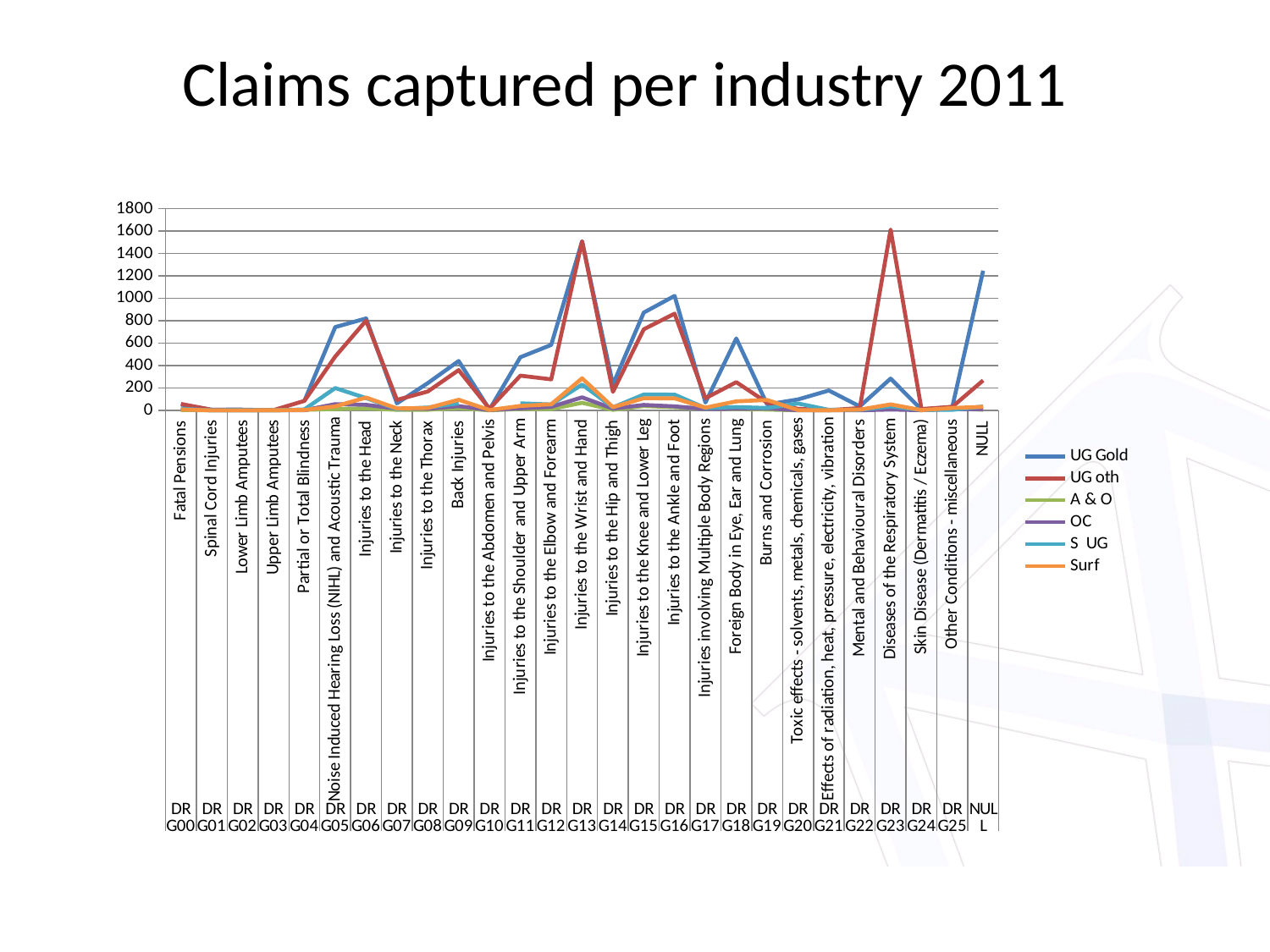
For Diseases of the Respiratory System, which series is larger: UG Gold or UG oth? UG oth Which category has the highest UG Gold value? Injuries to the Wrist and Hand What kind of chart is shown on the slide? line chart Is the UG oth value for Foreign Body in Eye, Ear and Lung greater or less than 400? less For Foreign Body in Eye, Ear and Lung, which series is larger: UG Gold or UG oth? UG Gold How many categories are plotted along the x axis? 27 Is the UG Gold value for Injuries to the Wrist and Hand greater or less than 1200? greater Is the UG Gold value for Injuries to the Ankle and Foot greater or less than 800? greater How many series does the legend list? 6 What is the title of the chart? Claims captured per industry 2011